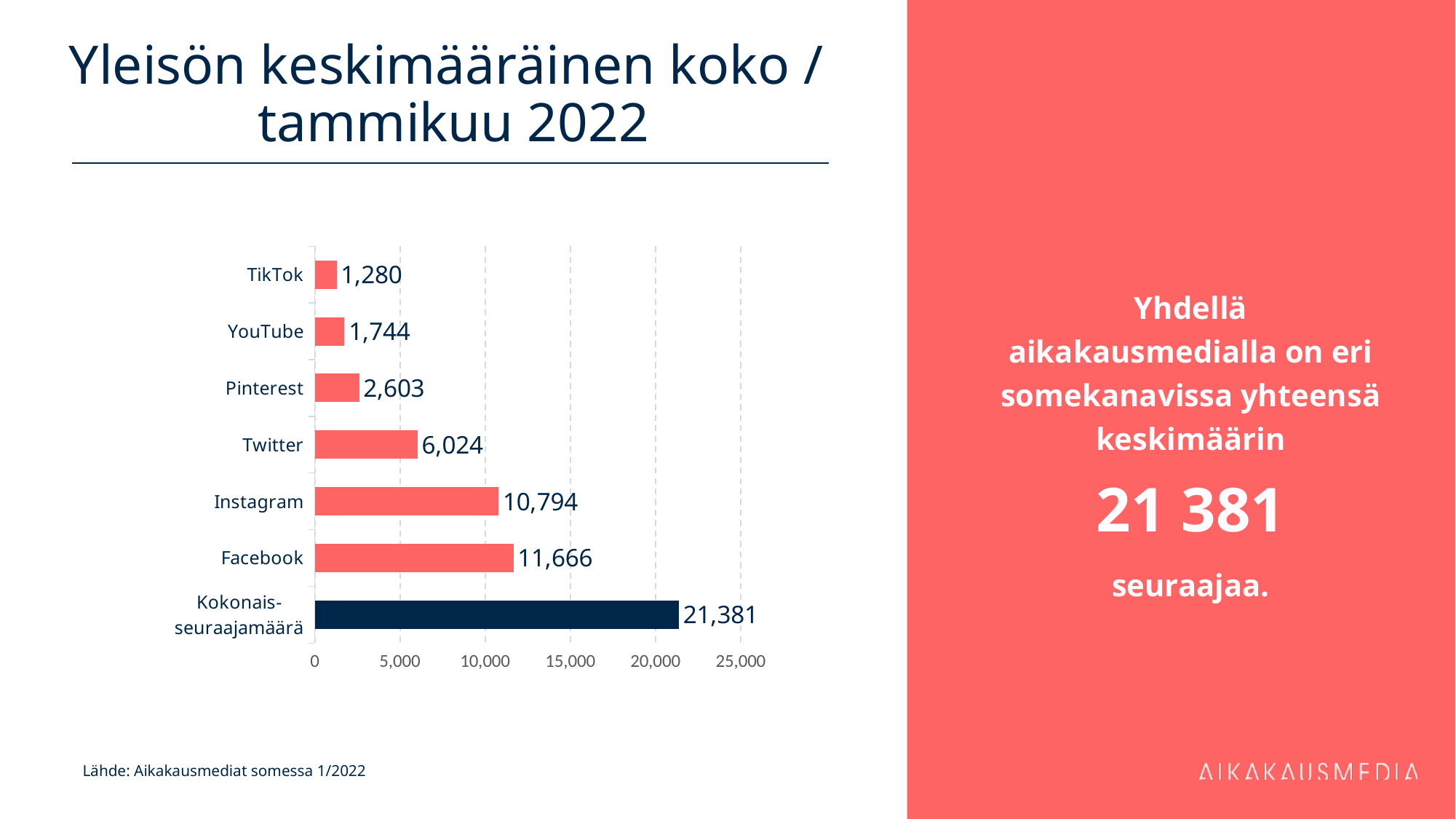
Which category has the lowest value? TikTok What is the difference between the values for Pinterest and YouTube? 859 What is the value for TikTok? 1,280 What kind of chart is shown on the slide? Bar chart Which individual social media channel has the highest value? Facebook Which is larger, the value for Twitter or the value for Pinterest? Twitter What is the value shown for Kokonais-seuraajamäärä? 21,381 How many bars are shown in the chart? 7 What is the value for Twitter? 6,024 What is the value for Facebook? 11,666 What is the difference between the values for Facebook and Instagram? 872 Is the value for Instagram greater or less than 10,000? greater